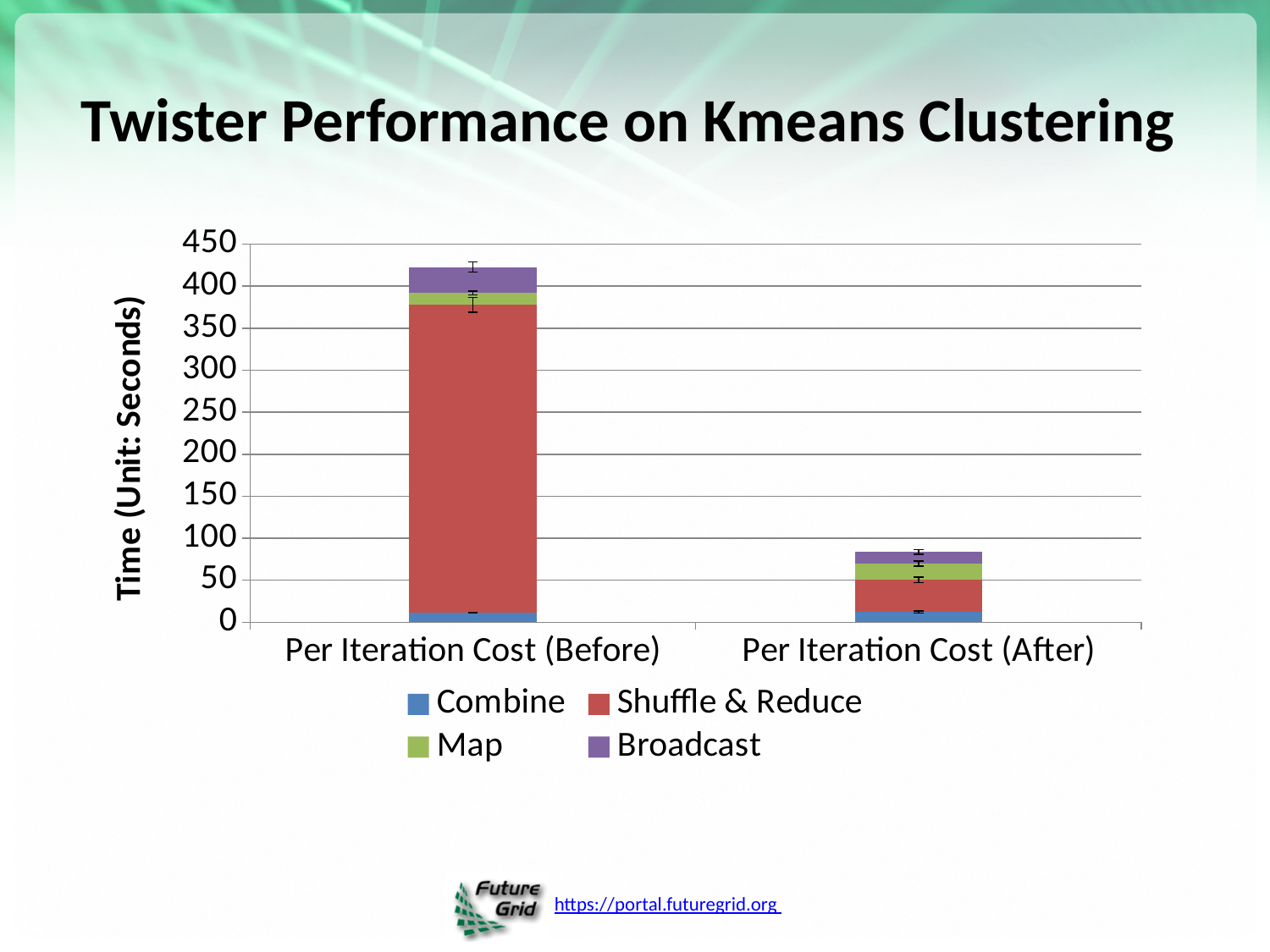
Is the total bar for Per Iteration Cost (Before) greater or less than 400? greater Is the Shuffle & Reduce segment for Per Iteration Cost (Before) greater or less than 300? greater Is the total bar for Per Iteration Cost (After) greater or less than 100? less How many categories are shown on the x axis? 2 What kind of chart is shown on the slide? stacked bar chart Which category has the higher total bar, Per Iteration Cost (Before) or Per Iteration Cost (After)? Per Iteration Cost (Before) What is the title of the chart? Twister Performance on Kmeans Clustering What is the label of the y axis? Time (Unit: Seconds) How many series does the legend list? 4 Which category has the lowest total bar? Per Iteration Cost (After) Do the total bar values rise or fall from Per Iteration Cost (Before) to Per Iteration Cost (After)? fall Which series takes up the largest share of the Per Iteration Cost (Before) bar? Shuffle & Reduce